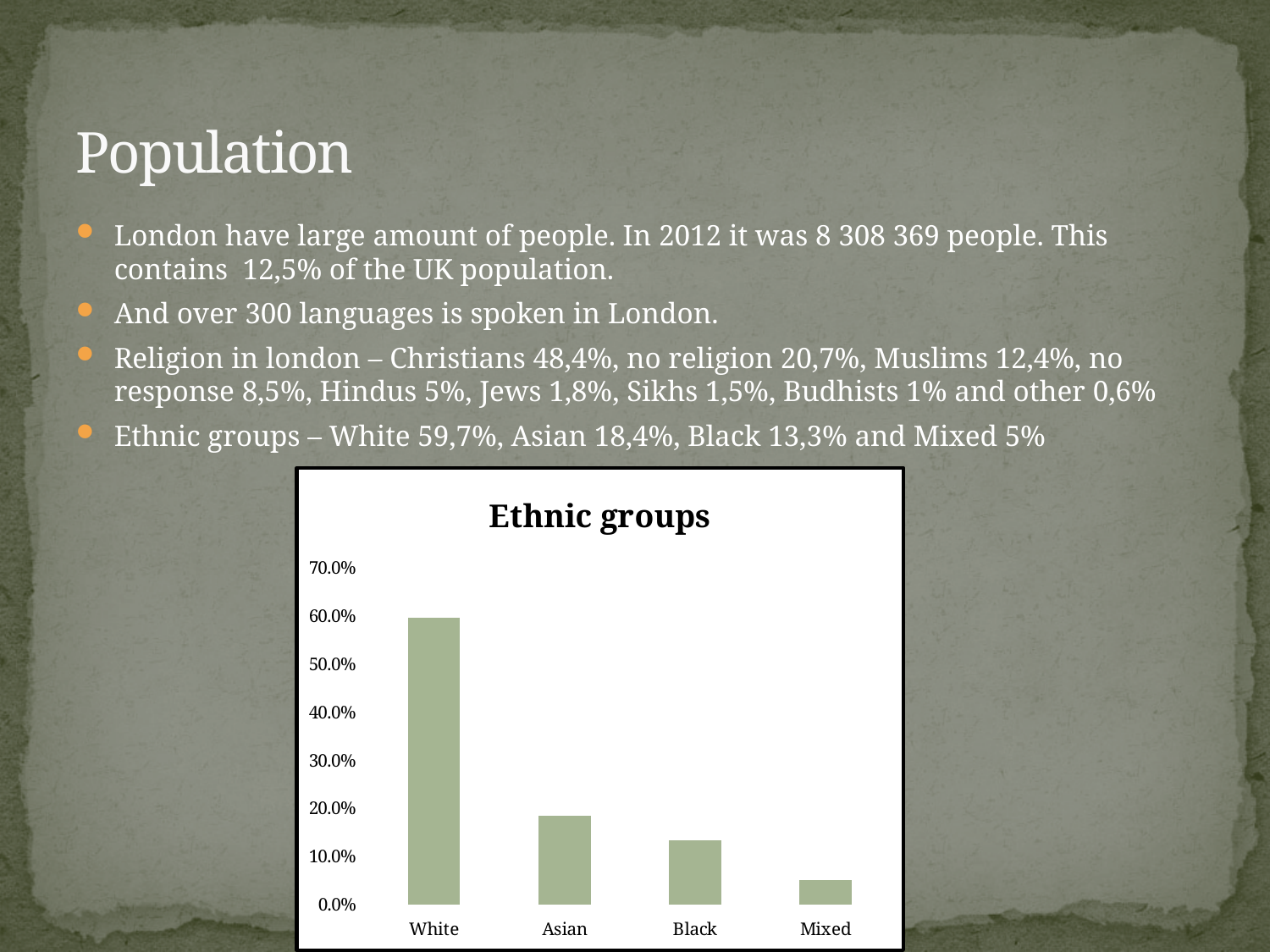
What kind of chart is shown on the slide? bar chart Is the value for Asian greater or less than 20.0%? less Which ethnic group has the highest bar in the chart? White Do the bar values rise or fall from left to right across the x axis? fall Is the value for Black greater or less than 10.0%? greater What is the highest value shown on the chart's y axis? 70.0% Is the value for White greater or less than 50.0%? greater How many categories are shown on the x axis of the chart? 4 Which is larger, the value for Asian or the value for Black? Asian Which ethnic group has the lowest bar in the chart? Mixed What is the title of the chart? Ethnic groups